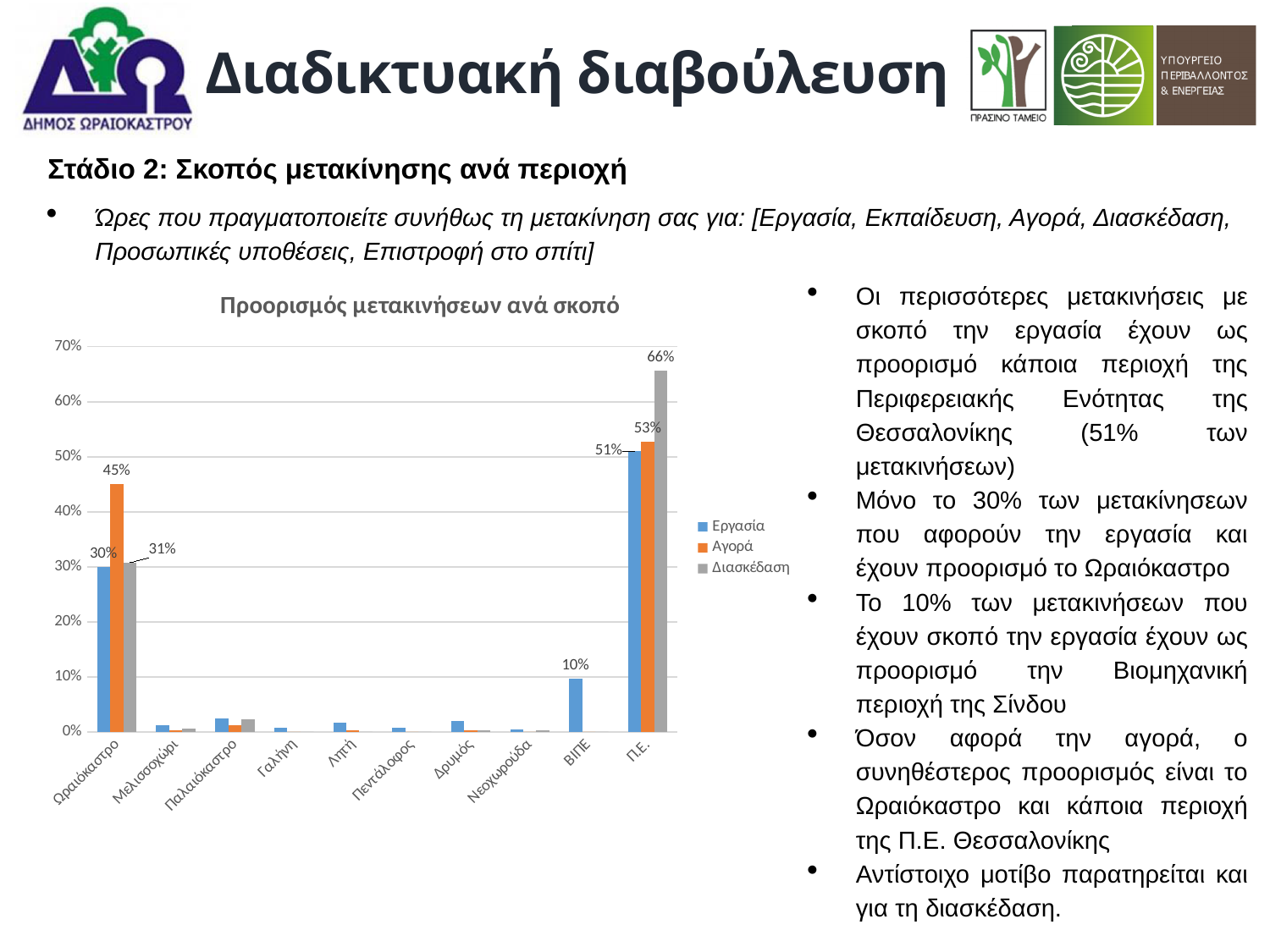
How many categories are shown on the x axis of the chart? 10 Is the Εργασία value for Μελισσοχώρι greater or less than 10%? less What is the value of the Αγορά series for Ωραιόκαστρο? 45% What is the difference between the Διασκέδαση values for Π.Ε. and Ωραιόκαστρο? 35 percentage points What is the value of the Διασκέδαση series for Π.Ε.? 66% What is the value of the Εργασία series for Ωραιόκαστρο? 30% Which is larger: the Εργασία value for Π.Ε. or the Εργασία value for Ωραιόκαστρο? Π.Ε. Which category has the highest value in the Διασκέδαση series? Π.Ε. What is the difference between the Αγορά and Εργασία values for Ωραιόκαστρο? 15 percentage points What is the value of the Εργασία series for ΒΙΠΕ? 10% How many series does the legend list? 3 What kind of chart is shown on the slide? Bar chart